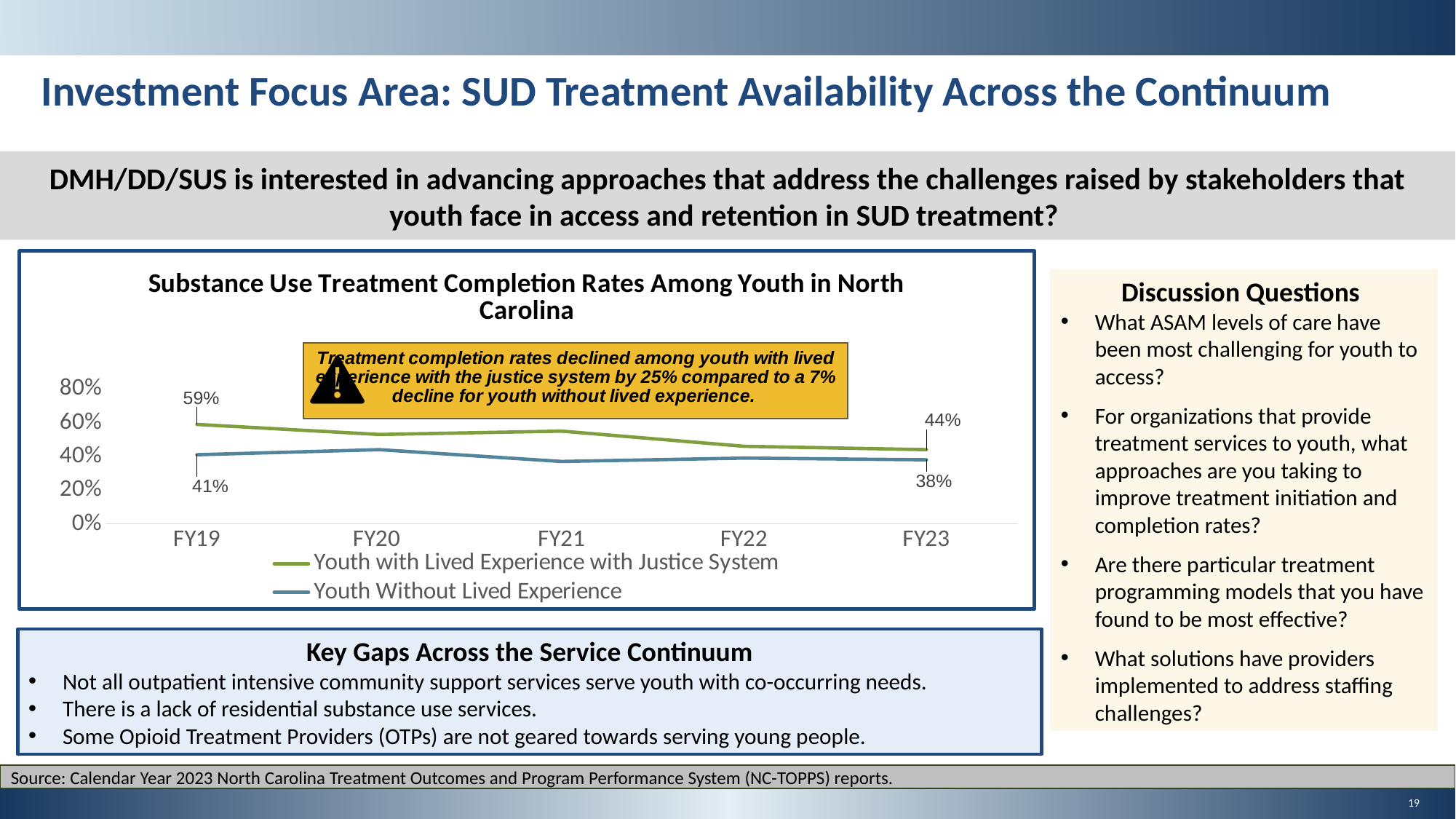
In FY19, what is the difference between the completion rates of Youth with Lived Experience with Justice System and Youth Without Lived Experience? 18 percentage points Is the FY20 value for Youth with Lived Experience with Justice System greater or less than 40%? greater What is the treatment completion rate for Youth with Lived Experience with Justice System in FY19? 59% Does the completion rate for Youth with Lived Experience with Justice System rise or fall from FY19 to FY23? Fall What is the FY23 value for Youth with Lived Experience with Justice System? 44% In FY23, which series has the higher completion rate: Youth with Lived Experience with Justice System or Youth Without Lived Experience? Youth with Lived Experience with Justice System What is the treatment completion rate for Youth Without Lived Experience in FY23? 38% What type of chart is used to show the treatment completion rates? Line chart By how many percentage points did the completion rate for Youth with Lived Experience with Justice System fall from FY19 to FY23? 15 percentage points How many series does the chart's legend list? 2 How many fiscal years are shown on the x axis of the chart? 5 Is the FY21 value for Youth Without Lived Experience greater or less than 40%? less